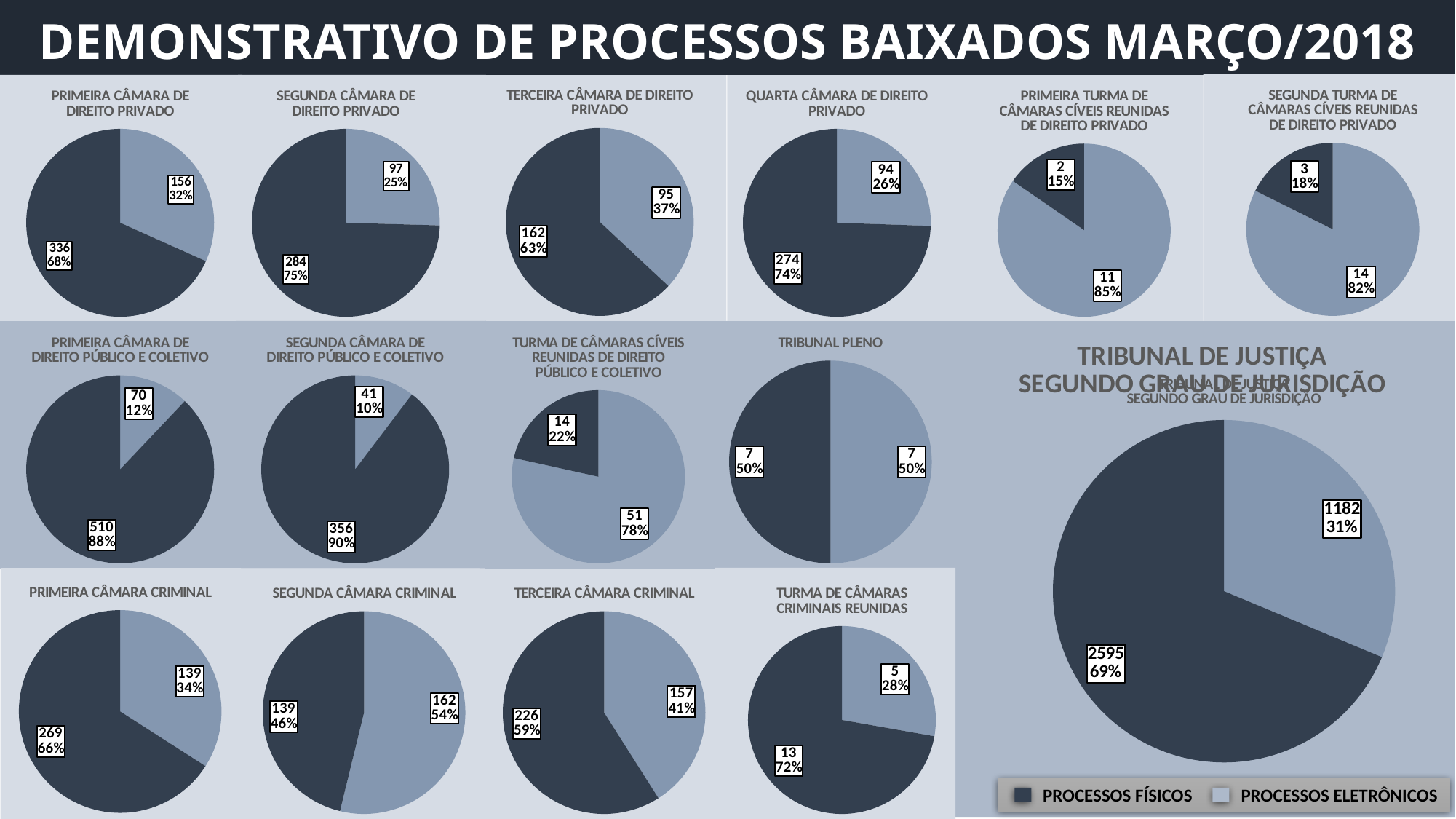
In the 'TRIBUNAL DE JUSTIÇA SEGUNDO GRAU DE JURISDIÇÃO' chart, what is the total of the two slices? 3777 In the 'SEGUNDA CÂMARA DE DIREITO PÚBLICO E COLETIVO' chart, how many processos eletrônicos are shown? 41 According to the legend, which series is shown in the dark colour? PROCESSOS FÍSICOS How many series does the legend at the bottom right of the slide list? 2 In the 'TRIBUNAL DE JUSTIÇA SEGUNDO GRAU DE JURISDIÇÃO' chart, what share of the pie is processos eletrônicos? 31% In the 'PRIMEIRA TURMA DE CÂMARAS CÍVEIS REUNIDAS DE DIREITO PRIVADO' chart, what percentage is shown for processos eletrônicos? 85% What kind of chart is used for 'QUARTA CÂMARA DE DIREITO PRIVADO'? pie chart In the 'TERCEIRA CÂMARA CRIMINAL' chart, what is the difference between processos físicos and processos eletrônicos? 69 In the 'PRIMEIRA CÂMARA DE DIREITO PRIVADO' chart, how many processos físicos are shown? 336 In the 'TURMA DE CÂMARAS CRIMINAIS REUNIDAS' chart, how many processos físicos are shown? 13 In the 'TRIBUNAL PLENO' chart, what percentage is shown for processos físicos? 50% In the 'SEGUNDA CÂMARA CRIMINAL' chart, which slice is larger, processos físicos or processos eletrônicos? processos eletrônicos